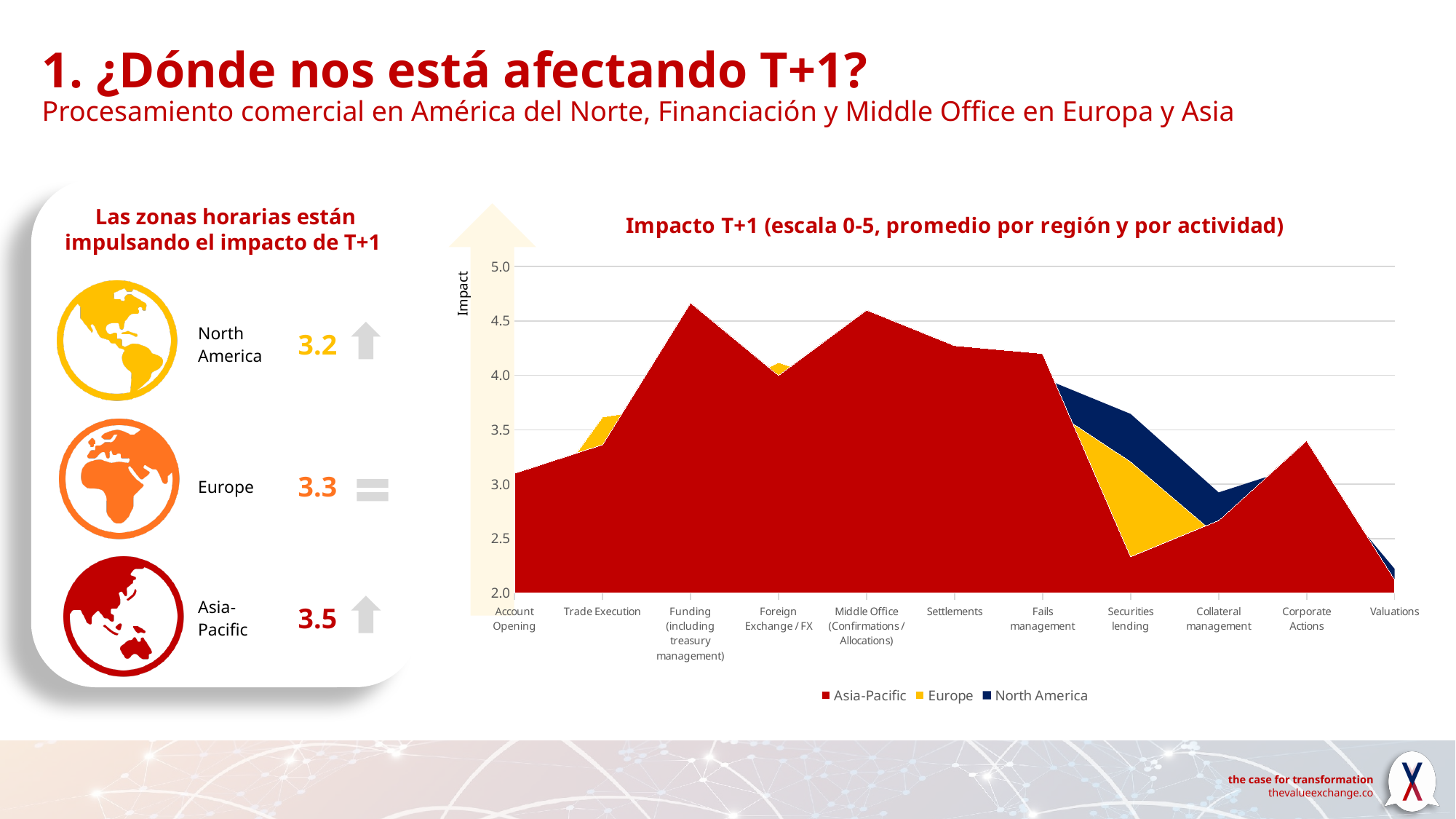
For which activity does the Asia-Pacific series reach its highest value? Funding (including treasury management) Is the Asia-Pacific value for Fails management greater or less than 4.0? greater How many activity categories are shown along the x axis of the chart? 11 Is the Asia-Pacific value for Securities lending greater or less than 2.5? less What is the title of the chart? Impacto T+1 (escala 0-5, promedio por región y por actividad) How many series does the chart legend list? 3 What kind of chart is shown on the slide? area chart Is the Asia-Pacific value for Funding (including treasury management) greater or less than 4.5? greater At Securities lending, which series has the larger value, Europe or Asia-Pacific? Europe What is the label on the vertical axis of the chart? Impact Does the Asia-Pacific series rise or fall between Fails management and Securities lending? fall